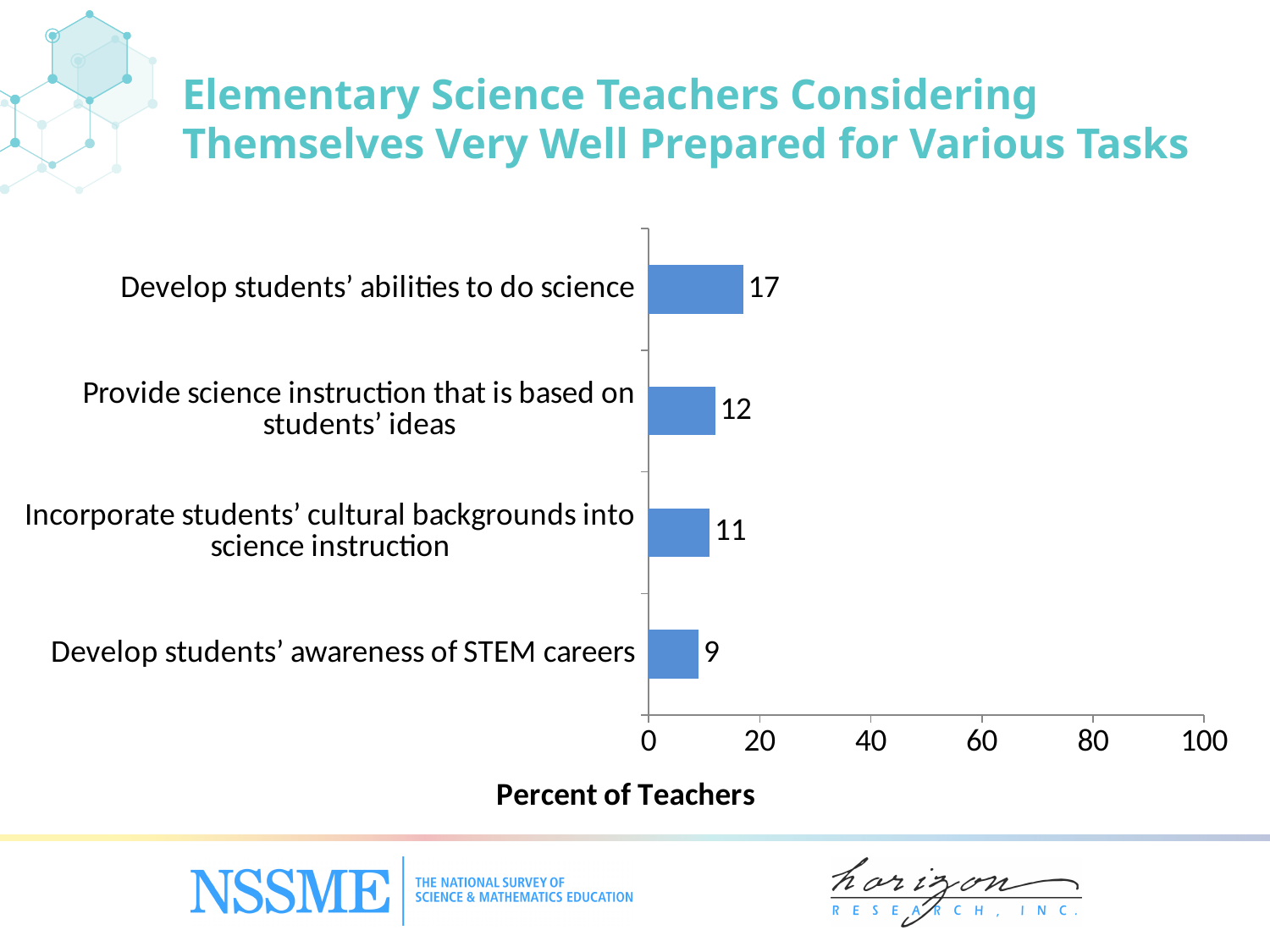
Is the value for 'Develop students' abilities to do science' greater or less than 20? less What is the value for 'Develop students' awareness of STEM careers'? 9 Which is larger: the value for 'Provide science instruction that is based on students' ideas' or the value for 'Develop students' awareness of STEM careers'? Provide science instruction that is based on students' ideas How many tasks are shown in the chart? 4 What is the label of the horizontal axis? Percent of Teachers Which task has the lowest percent of teachers considering themselves very well prepared? Develop students' awareness of STEM careers What kind of chart is shown on the slide? Bar chart What is the value for 'Incorporate students' cultural backgrounds into science instruction'? 11 Which task has the highest percent of teachers considering themselves very well prepared? Develop students' abilities to do science What is the difference between the values for 'Develop students' abilities to do science' and 'Develop students' awareness of STEM careers'? 8 What percent of teachers consider themselves very well prepared to develop students' abilities to do science? 17 What is the value for 'Provide science instruction that is based on students' ideas'? 12